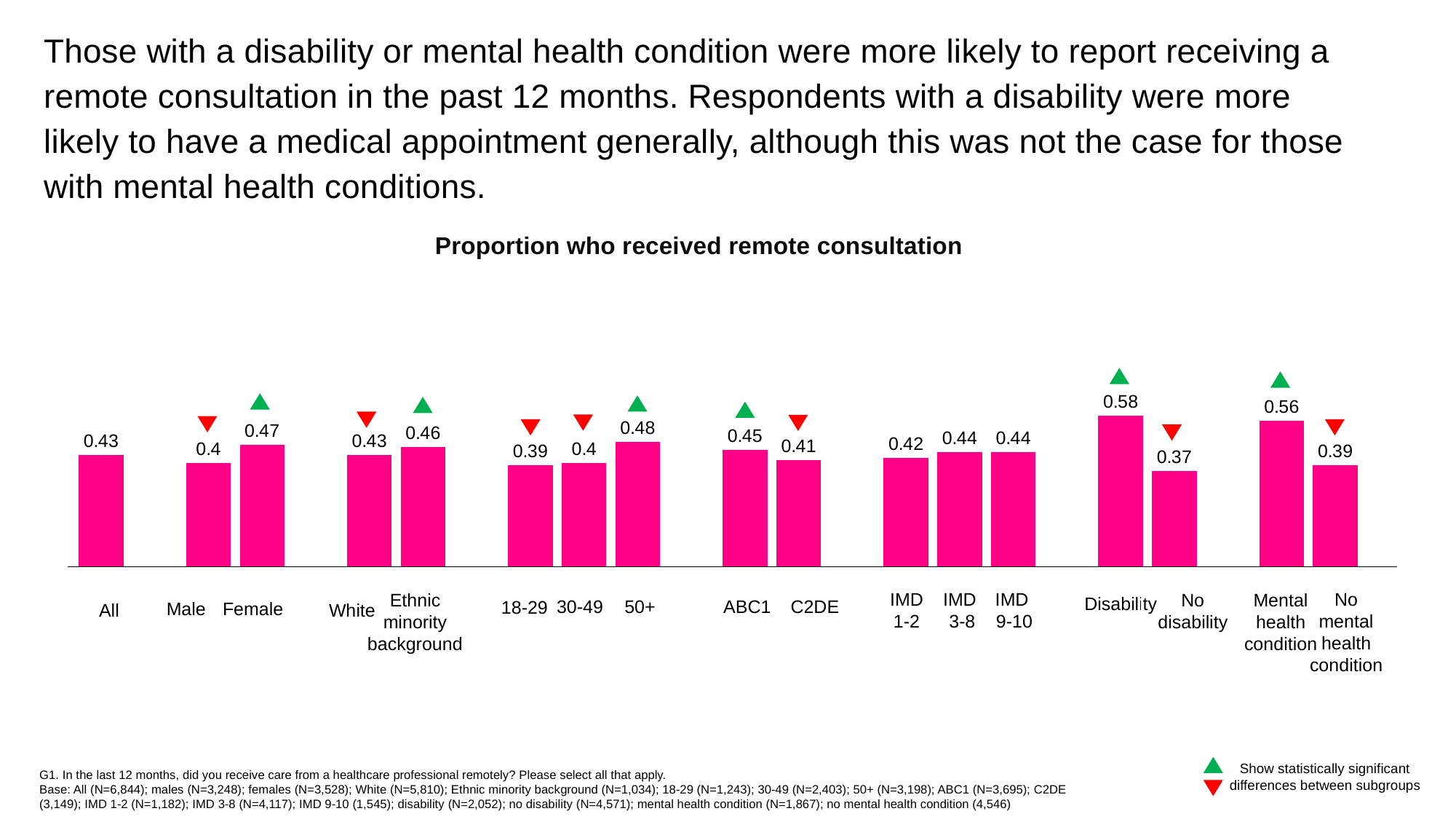
Which category has the lowest value? No disability What is the value for Female? 0.47 What is the value for Disability? 0.58 What is the value for the 18-29 age group? 0.39 What is the difference between the values for Disability and No disability? 0.21 What is the title of the chart? Proportion who received remote consultation How many bars are shown in the chart? 17 Which is larger, the value for ABC1 or the value for C2DE? ABC1 What kind of chart is shown? Bar chart What is the value for Ethnic minority background? 0.46 What is the difference between the values for Female and Male? 0.07 Which category has the highest value? Disability